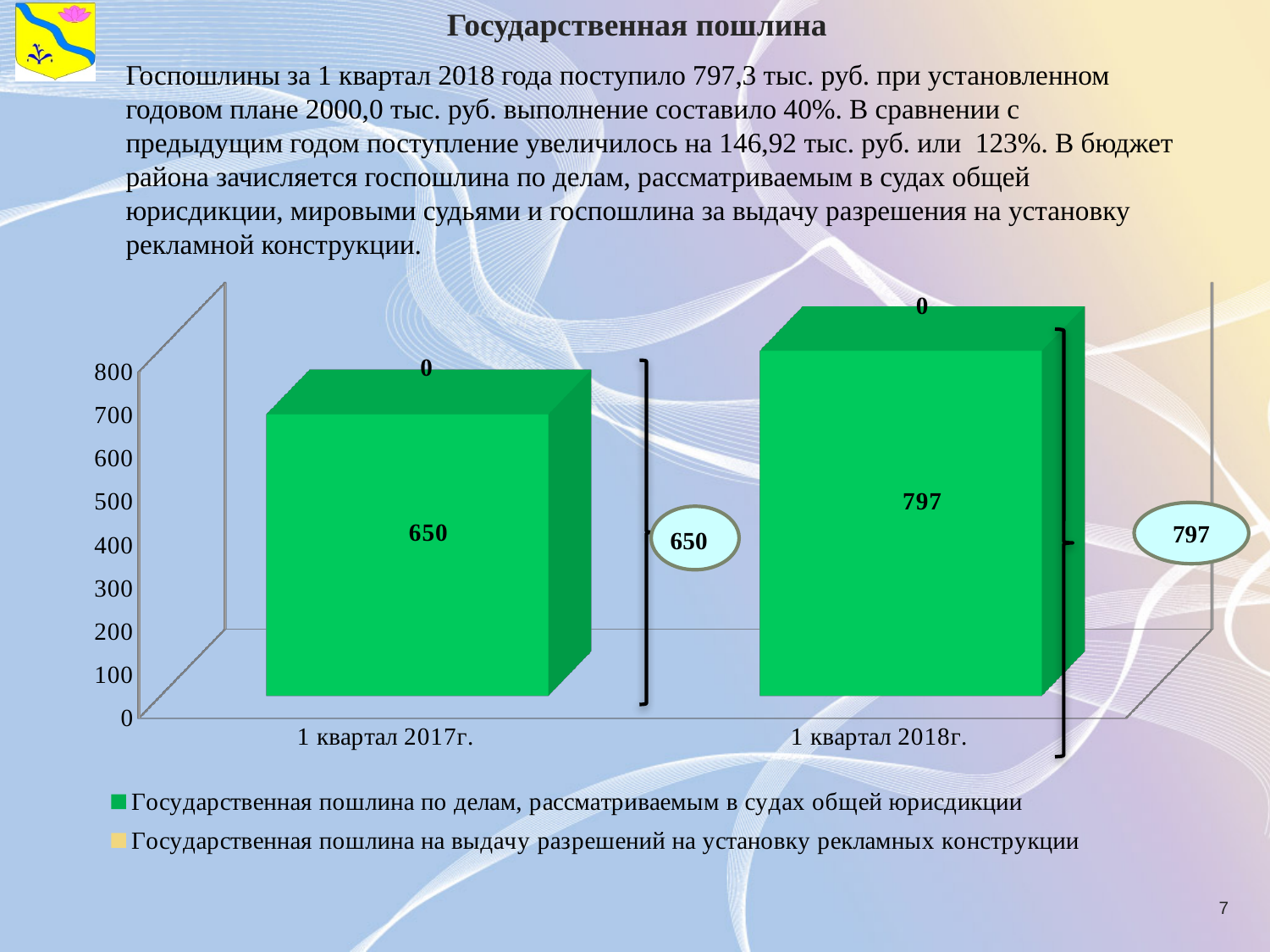
What is the value of the series Государственная пошлина на выдачу разрешений на установку рекламных конструкции for 1 квартал 2018г.? 0 What is the total of the stacked bar for 1 квартал 2018г.? 797 Which category has the higher value for the green series? 1 квартал 2018г. What is the value of the green series (Государственная пошлина по делам, рассматриваемым в судах общей юрисдикции) for 1 квартал 2017г.? 650 How many categories are shown on the x axis of the chart? 2 Is the green series value for 1 квартал 2017г. greater or less than 700? less How many series does the chart legend list? 2 What kind of chart is shown on the slide? bar chart By how much does the green series value for 1 квартал 2018г. exceed that for 1 квартал 2017г.? 147 Is the green series value for 1 квартал 2018г. greater or less than 700? greater Which category has the lower value for the green series? 1 квартал 2017г. What is the value of the green series (Государственная пошлина по делам, рассматриваемым в судах общей юрисдикции) for 1 квартал 2018г.? 797